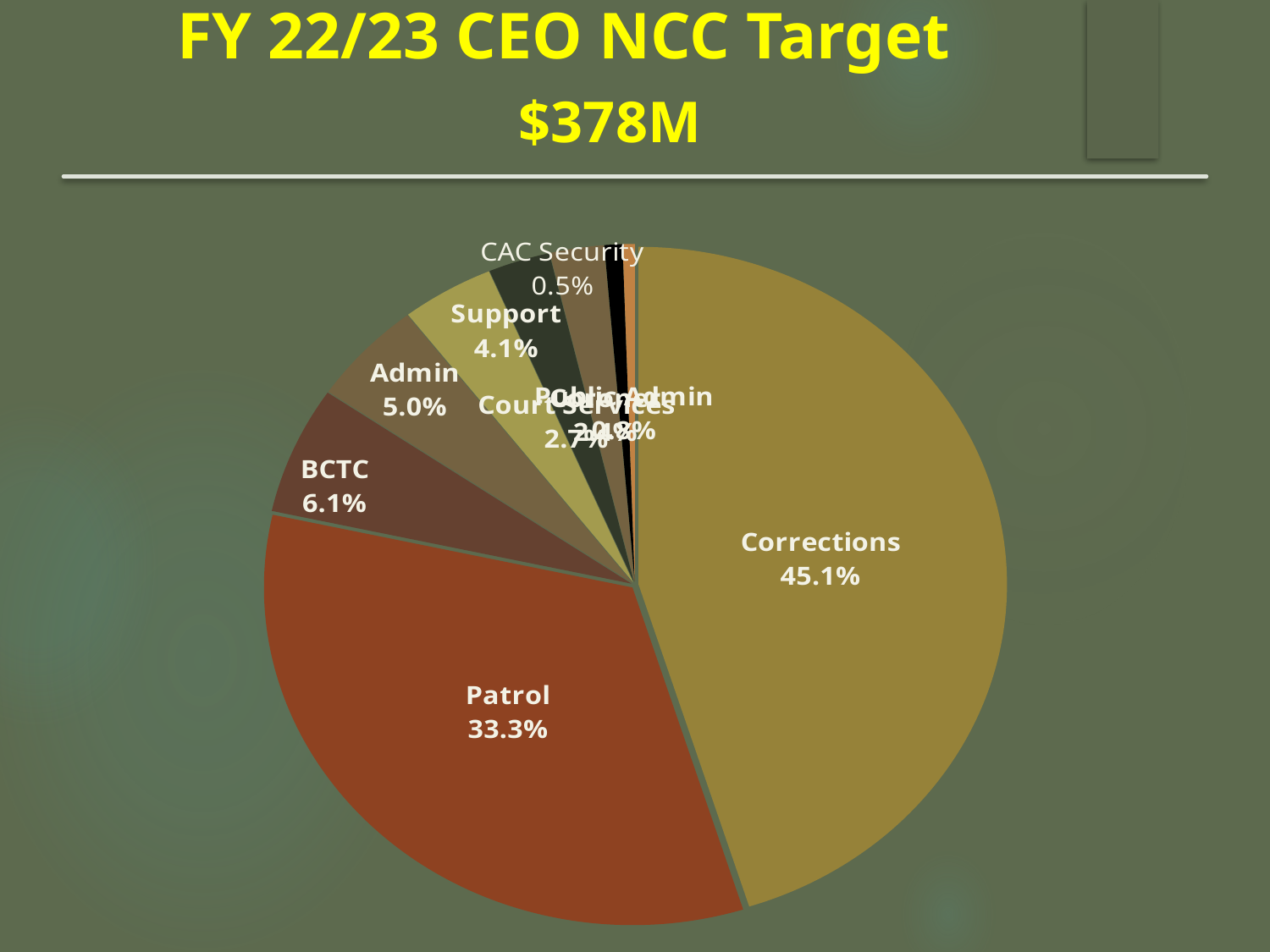
What percentage is shown for Patrol? 33.3% Which is larger, the Admin slice or the Support slice? Admin What share of the pie does Corrections represent? 45.1% What percentage is shown for BCTC? 6.1% Which category has the largest slice of the pie? Corrections Which is larger, the Patrol slice or the BCTC slice? Patrol What kind of chart is shown on the slide? pie chart What percentage is shown for Support? 4.1% What percentage is shown for Admin? 5.0% What percentage is shown for CAC Security? 0.5% What is the title of the slide? FY 22/23 CEO NCC Target $378M What is the difference in percentage points between Corrections and Patrol? 11.8 percentage points